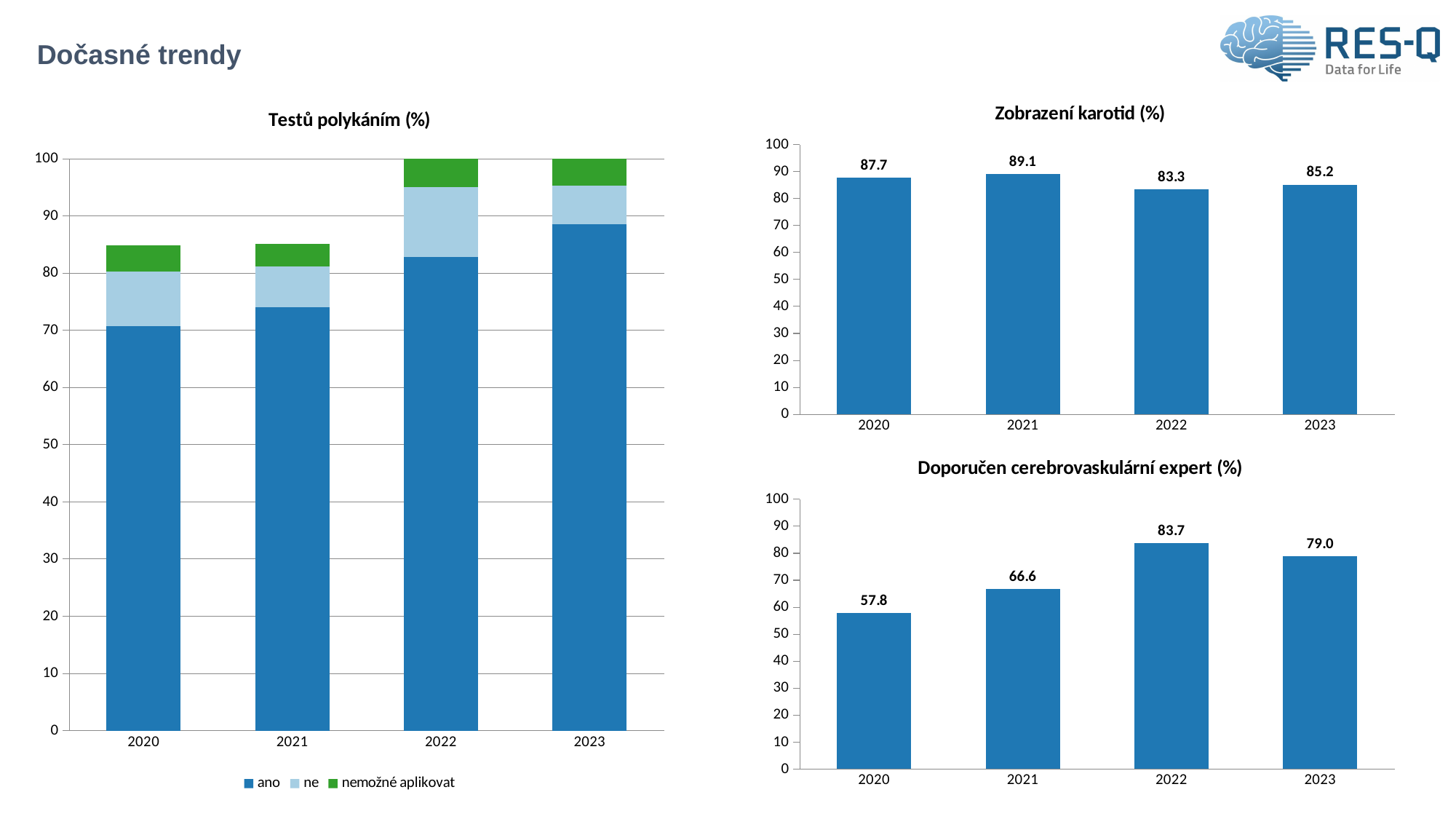
In the 'Testů polykáním (%)' chart, is the 'ano' value for 2023 greater or less than 80? greater In the 'Zobrazení karotid (%)' chart, what is the difference between the 2021 and 2022 values? 5.8 In the 'Testů polykáním (%)' chart, is the 'ano' value for 2020 greater or less than 80? less How many years are shown on the x axis of the 'Zobrazení karotid (%)' chart? 4 In the 'Zobrazení karotid (%)' chart, which year has the lowest value? 2022 In the 'Doporučen cerebrovaskulární expert (%)' chart, what is the value for 2020? 57.8 In the 'Zobrazení karotid (%)' chart, what is the value for 2021? 89.1 In the 'Doporučen cerebrovaskulární expert (%)' chart, what is the difference between the 2023 and 2020 values? 21.2 What kind of chart is 'Testů polykáním (%)'? Stacked bar chart In the 'Testů polykáním (%)' chart, how many series does the legend list? 3 In the 'Doporučen cerebrovaskulární expert (%)' chart, which year has the highest value? 2022 In the 'Doporučen cerebrovaskulární expert (%)' chart, which is larger, the value for 2022 or the value for 2023? 2022